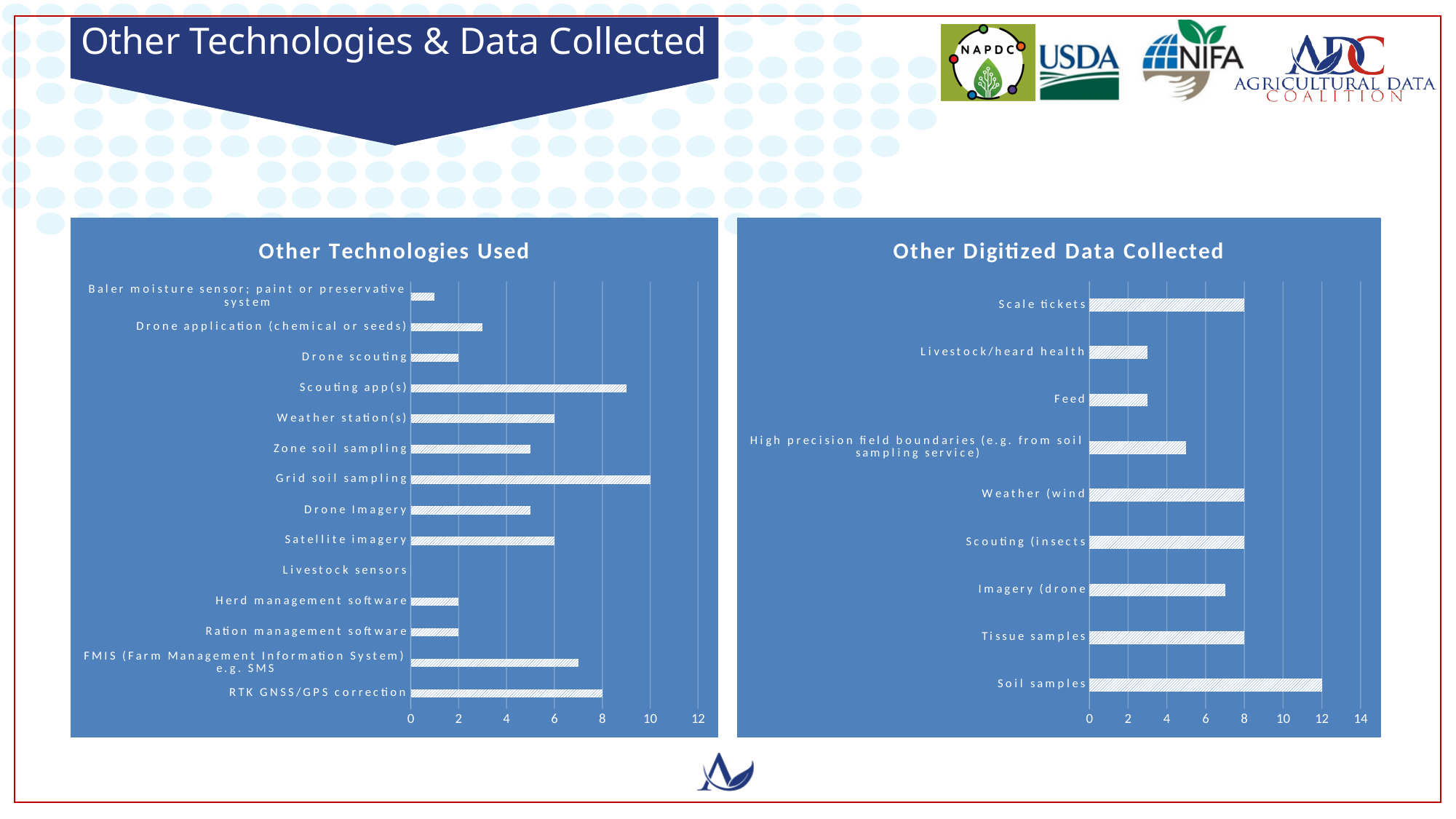
On the 'Other Technologies Used' chart, what is the value for RTK GNSS/GPS correction? 8 On the 'Other Digitized Data Collected' chart, which category has the highest value? Soil samples What kind of chart is the 'Other Technologies Used' chart? Bar chart On the 'Other Technologies Used' chart, which category has the highest value? Grid soil sampling On the 'Other Digitized Data Collected' chart, is the value for High precision field boundaries (e.g. from soil sampling service) greater or less than 6? less On the 'Other Technologies Used' chart, what is the value for Grid soil sampling? 10 On the 'Other Digitized Data Collected' chart, what is the value for Soil samples? 12 On the 'Other Technologies Used' chart, is the value for Scouting app(s) greater or less than 8? greater On the 'Other Digitized Data Collected' chart, which is larger, Imagery (drone) or Feed? Imagery (drone) How many categories are shown on the 'Other Digitized Data Collected' chart? 9 On the 'Other Technologies Used' chart, what is the difference between Grid soil sampling and RTK GNSS/GPS correction? 2 On the 'Other Technologies Used' chart, which category has the lowest value? Livestock sensors